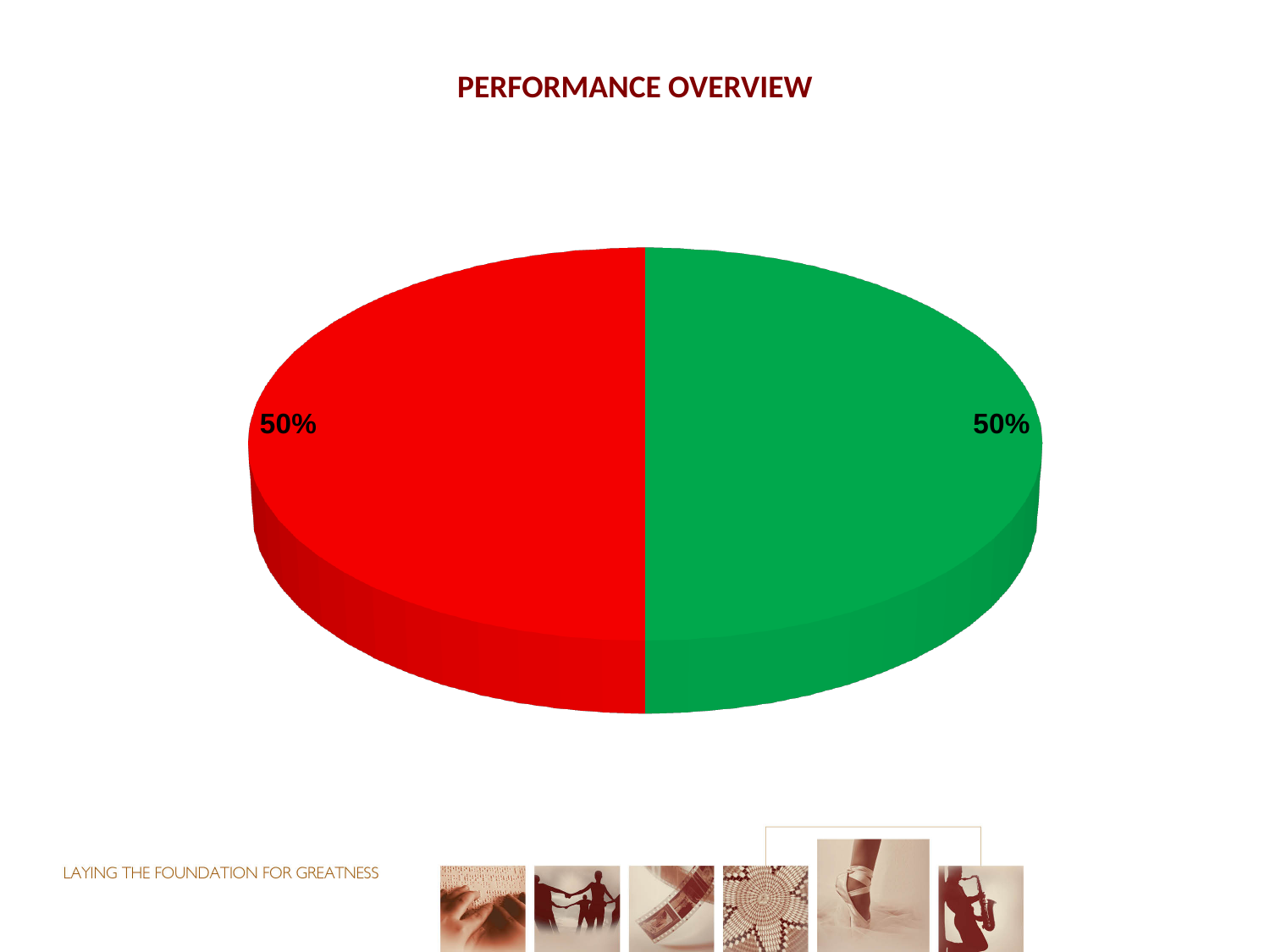
What share of the pie does the red slice represent? 50% Is the share of the red slice greater or less than 75%? less What share of the pie does the green slice represent? 50% What kind of chart is shown on the slide? pie chart What two colours are used for the slices of the pie chart? red and green What is the difference between the red slice's share and the green slice's share? 0% What is the title of the chart? PERFORMANCE OVERVIEW How many slices does the pie chart have? 2 Is the share of the green slice greater or less than 25%? greater